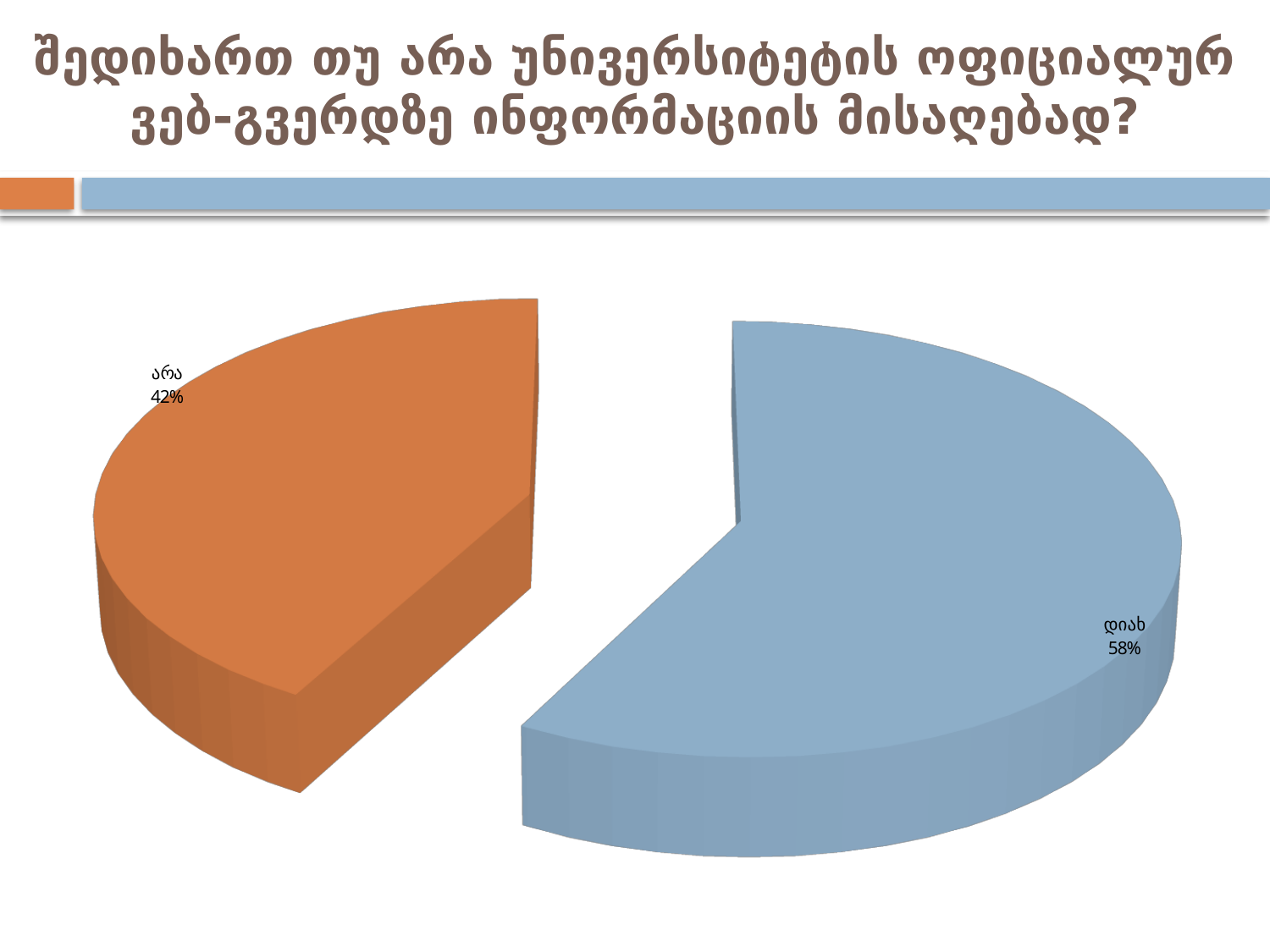
What is the difference in percentage points between the "დიახ" slice and the "არა" slice? 16 How many slices does the pie chart have? 2 What share of the pie does the "არა" slice represent? 42% Which slice of the pie is the largest? დიახ What percentage is shown for the slice labelled "არა"? 42% What colour is the "დიახ" slice? Blue Which slice of the pie is the smallest? არა Which is larger, the "დიახ" slice or the "არა" slice? დიახ What percentage is shown for the slice labelled "დიახ"? 58% What kind of chart is shown on the slide? Pie chart What colour is the "არა" slice? Orange